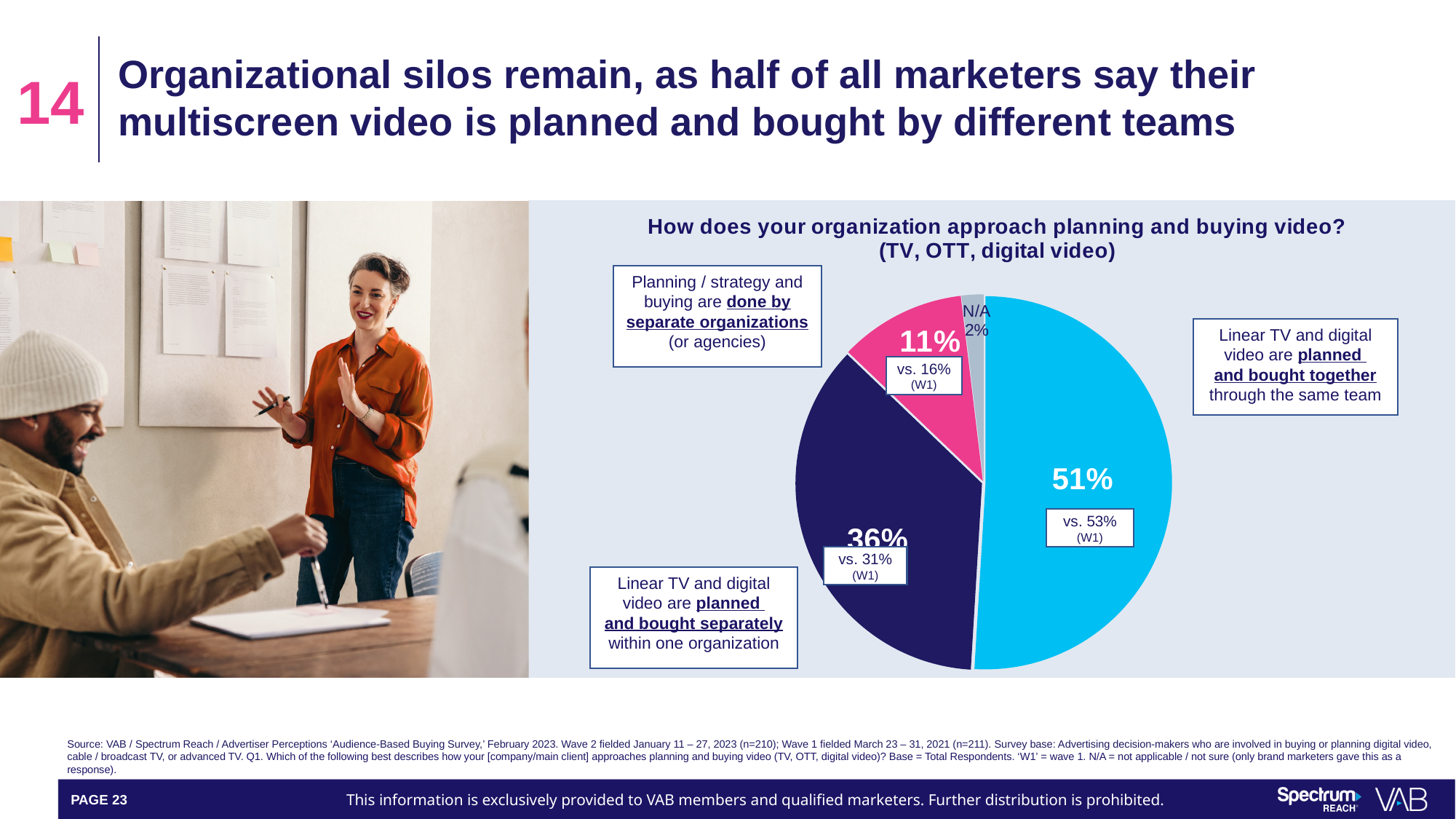
What was the Wave 1 (W1) value for planned and bought together through the same team? 53% What was the Wave 1 (W1) value for done by separate organizations (or agencies)? 16% What was the Wave 1 (W1) value for planned and bought separately within one organization? 31% What is the difference in percentage points between the 'planned and bought together' slice and the 'planned and bought separately within one organization' slice? 15 Which response has the largest slice of the pie? Linear TV and digital video are planned and bought together through the same team What share of respondents say linear TV and digital video are planned and bought separately within one organization? 36% What share of respondents say linear TV and digital video are planned and bought together through the same team? 51% Which response has the smallest slice of the pie? N/A How many slices does the pie chart have? 4 What share of respondents answered N/A? 2% What kind of chart is shown on the slide? pie chart What share of respondents say planning / strategy and buying are done by separate organizations (or agencies)? 11%